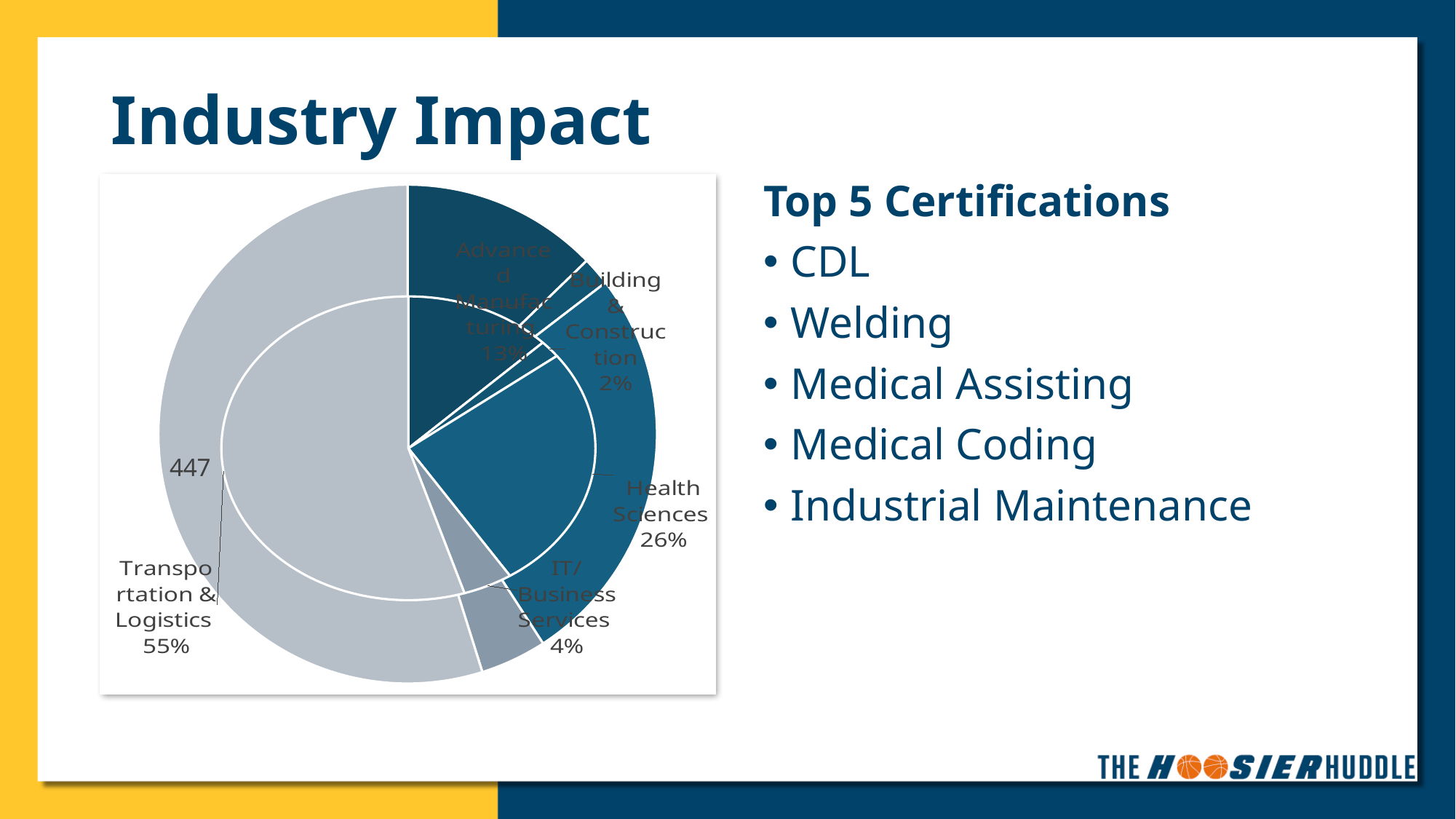
What share of the pie does Health Sciences represent? 26% What share of the pie does Advanced Manufacturing represent? 13% What share of the pie does IT/Business Services represent? 4% Which category has the smallest slice of the pie? Building & Construction What number is printed next to the Transportation & Logistics slice? 447 How many categories are shown in the pie chart? 5 Which is larger, the share for Health Sciences or the share for IT/Business Services? Health Sciences Which category has the largest slice of the pie? Transportation & Logistics What is the difference in percentage points between Health Sciences and Advanced Manufacturing? 13 What kind of chart is shown on the slide? pie chart